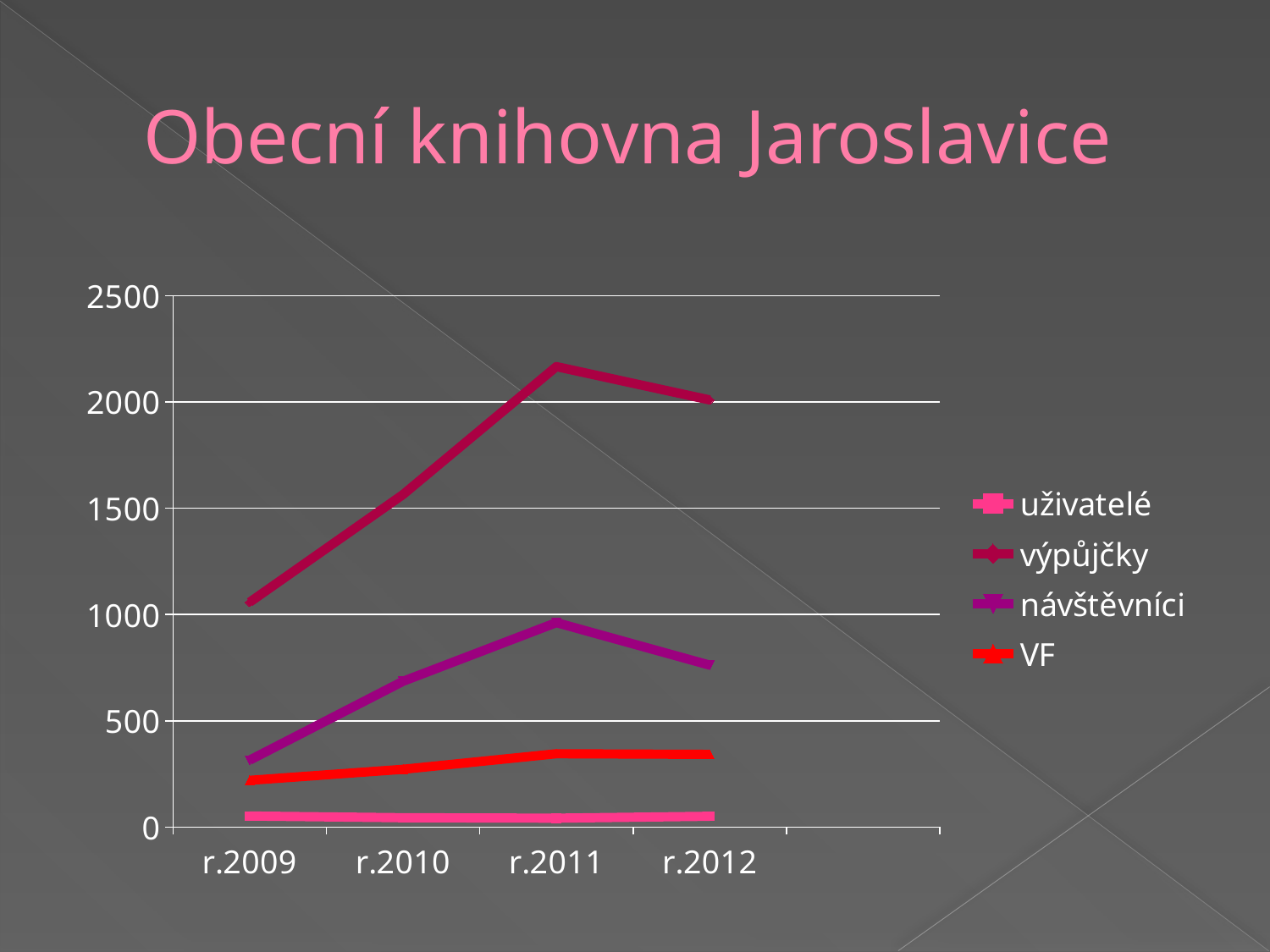
In which year is the výpůjčky series at its lowest value? r.2009 Is the value for návštěvníci in r.2009 greater or less than 500? less What is the title of the slide above the chart? Obecní knihovna Jaroslavice How many years are shown on the x axis? 4 How many series does the legend list? 4 Which series is plotted with the highest values across all years? výpůjčky Does the výpůjčky series rise or fall from r.2009 to r.2011? rise What kind of chart is shown on the slide? line chart Which series is plotted with the lowest values across all years? uživatelé In which year does the výpůjčky series reach its highest value? r.2011 Is the value for výpůjčky in r.2011 greater or less than 2000? greater